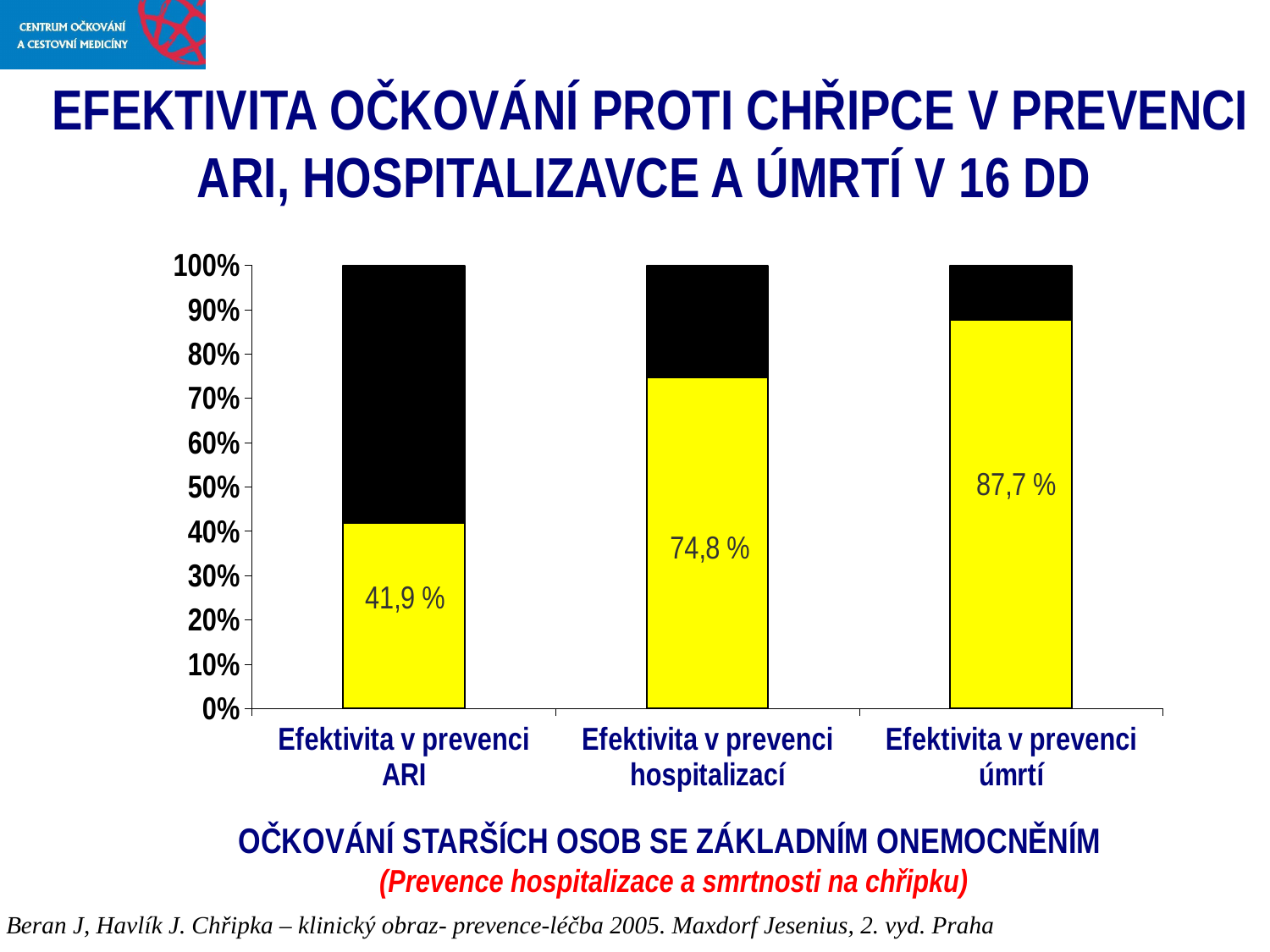
What is the labelled value of the yellow segment for 'Efektivita v prevenci úmrtí'? 87,7 % Do the labelled yellow values rise or fall from left to right across the categories? Rise Which is larger: the labelled value for 'Efektivita v prevenci hospitalizací' or for 'Efektivita v prevenci úmrtí'? Efektivita v prevenci úmrtí What is the labelled value of the yellow segment for 'Efektivita v prevenci ARI'? 41,9 % What is the difference between the labelled values for 'Efektivita v prevenci úmrtí' and 'Efektivita v prevenci ARI'? 45,8 % How many categories are shown on the x axis? 3 Which category has the highest labelled yellow value? Efektivita v prevenci úmrtí What is the difference between the labelled values for 'Efektivita v prevenci hospitalizací' and 'Efektivita v prevenci ARI'? 32,9 % Which category has the lowest labelled yellow value? Efektivita v prevenci ARI Is the labelled yellow value for 'Efektivita v prevenci ARI' greater or less than 50%? less What kind of chart is shown on the slide? Stacked bar chart What is the labelled value of the yellow segment for 'Efektivita v prevenci hospitalizací'? 74,8 %